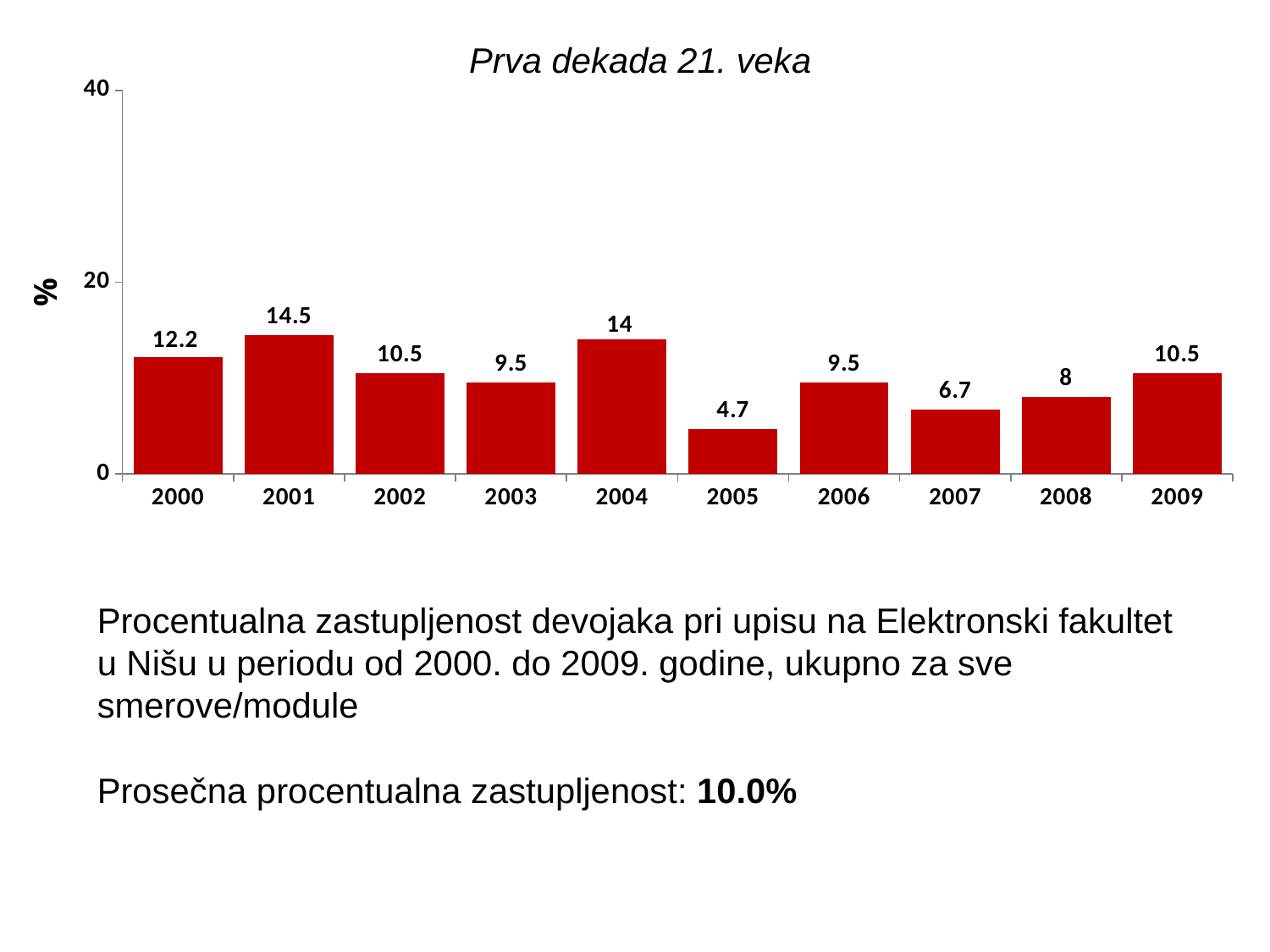
Is the value for 2001 greater or less than 20? less Which year has the highest value? 2001 Which is larger, the value for 2004 or the value for 2008? 2004 What is the value for 2005? 4.7 What is the value for 2007? 6.7 What kind of chart is shown on the slide? bar chart Which year has the lowest value? 2005 What is the difference between the values for 2000 and 2004? 1.8 What is the title of the chart? Prva dekada 21. veka What is the value for 2001? 14.5 How many years are shown on the x axis? 10 What is the difference between the values for 2001 and 2005? 9.8